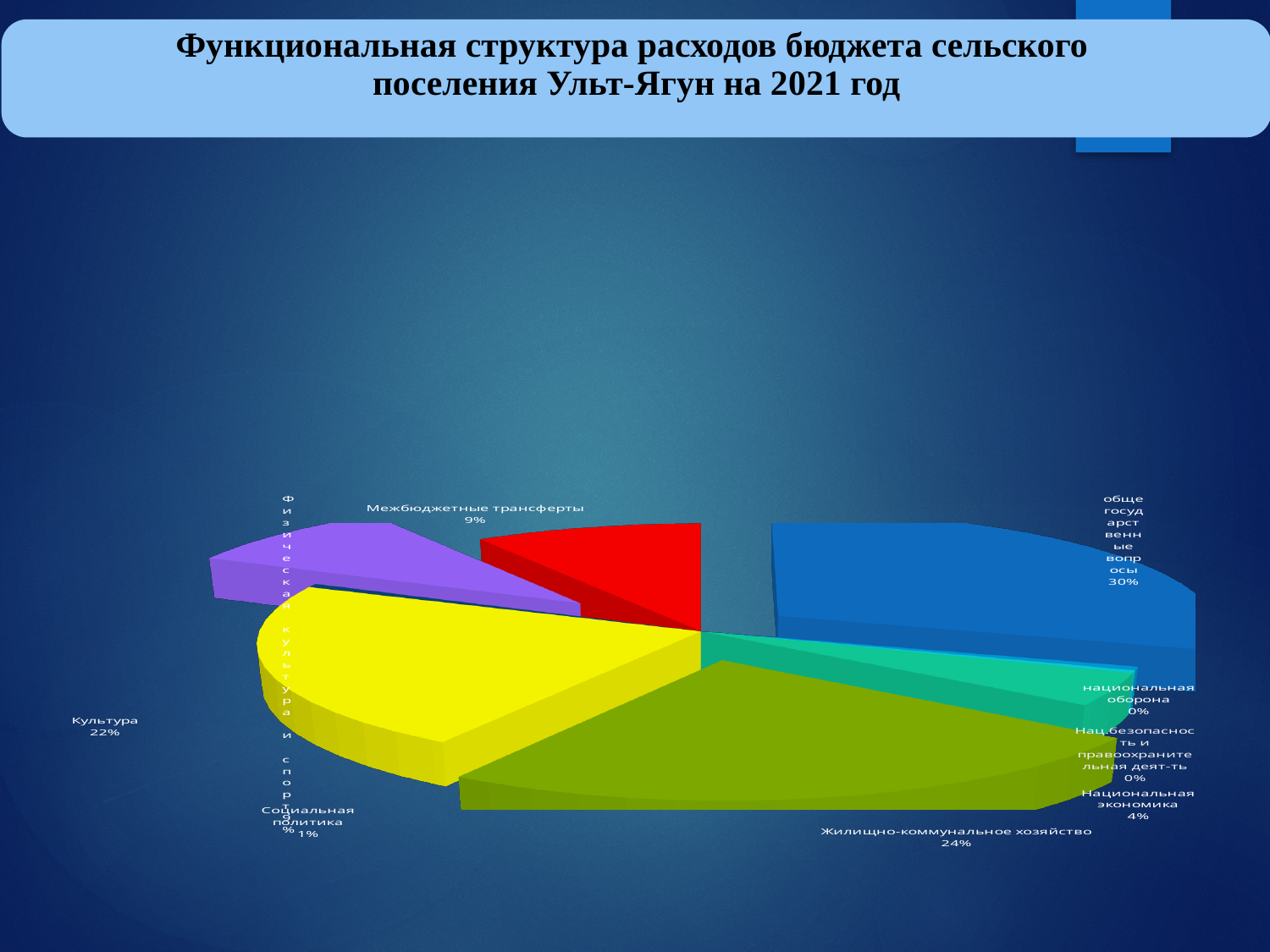
What share of the budget expenditures goes to Жилищно-коммунальное хозяйство? 24% What share of the budget expenditures goes to Межбюджетные трансферты? 9% Which is larger: the share for Культура or the share for Межбюджетные трансферты? Культура What kind of chart is shown on the slide? pie chart How many categories are shown in the pie chart? 9 What share of the budget expenditures goes to Социальная политика? 1% What is the title of the slide containing the chart? Функциональная структура расходов бюджета сельского поселения Ульт-Ягун на 2021 год Which category has the largest share of the budget expenditures? общегосударственные вопросы What share of the budget expenditures goes to Национальная экономика? 4% What is the difference in percentage points between общегосударственные вопросы and Жилищно-коммунальное хозяйство? 6 What share of the budget expenditures goes to общегосударственные вопросы? 30% What share of the budget expenditures goes to Культура? 22%